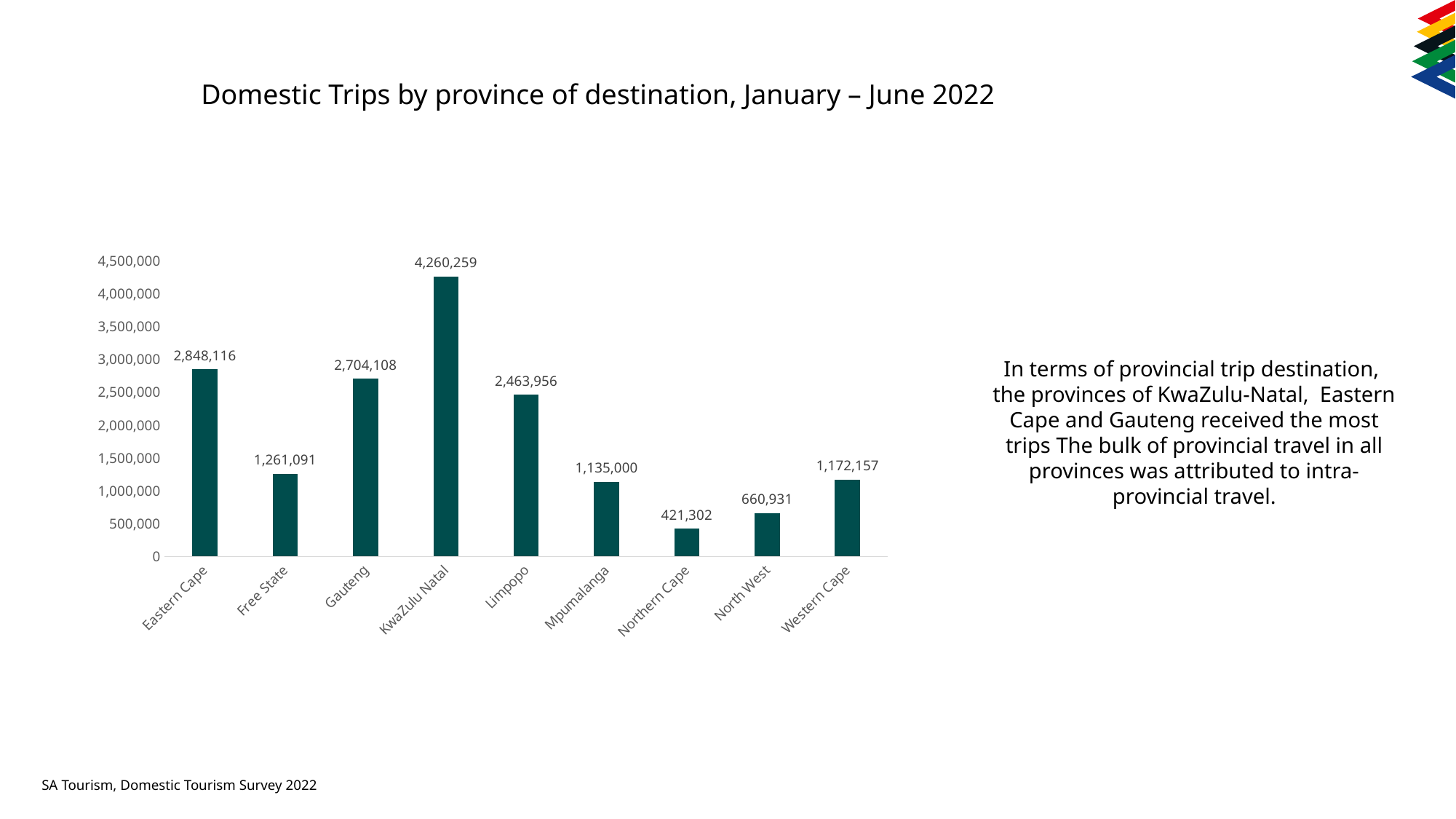
Which province had more domestic trips, Gauteng or Limpopo? Gauteng What is the difference between the trips to KwaZulu-Natal and Eastern Cape? 1,412,143 Which province received the fewest domestic trips? Northern Cape Which province received the most domestic trips? KwaZulu-Natal What kind of chart is shown on the slide? Bar chart Is the value for North West greater or less than 1,000,000? less What is the title of the chart? Domestic Trips by province of destination, January – June 2022 What is the number of domestic trips to KwaZulu-Natal? 4,260,259 What is the number of domestic trips to Northern Cape? 421,302 What is the number of domestic trips to Eastern Cape? 2,848,116 How many provinces are shown on the chart? 9 What is the number of domestic trips to Western Cape? 1,172,157